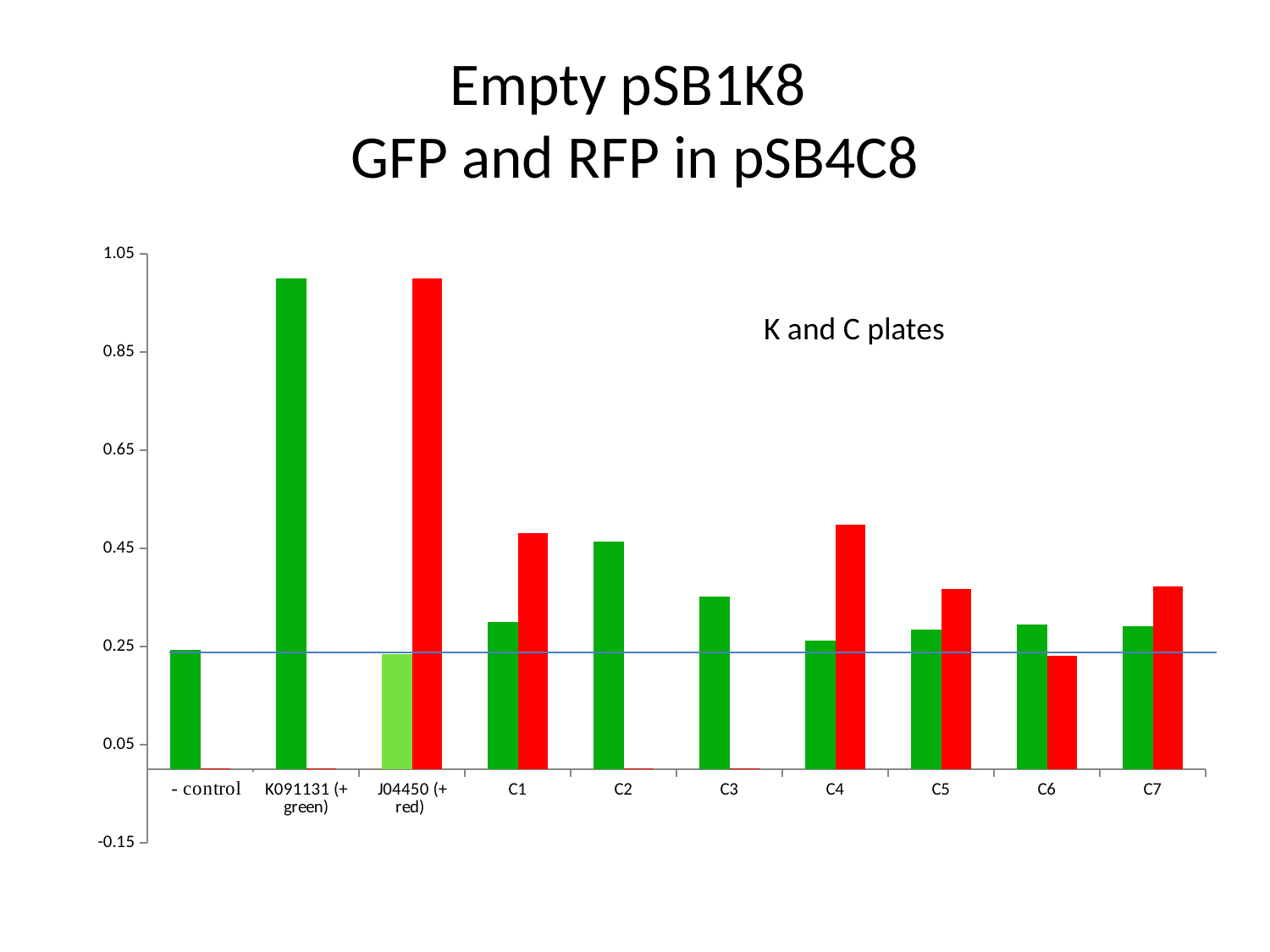
How many categories are shown along the x axis of the chart? 10 Is the red bar for C5 greater or less than 0.45? less Is the green bar for C3 greater or less than 0.45? less Which category has the tallest red bar? J04450 (+ red) Is the green bar for K091131 (+ green) greater or less than 0.85? greater Which category has the tallest green bar? K091131 (+ green) For C6, which bar is taller, the green bar or the red bar? green bar For C4, which bar is taller, the green bar or the red bar? red bar What kind of chart is shown on the slide? bar chart What is the title of the slide? Empty pSB1K8 GFP and RFP in pSB4C8